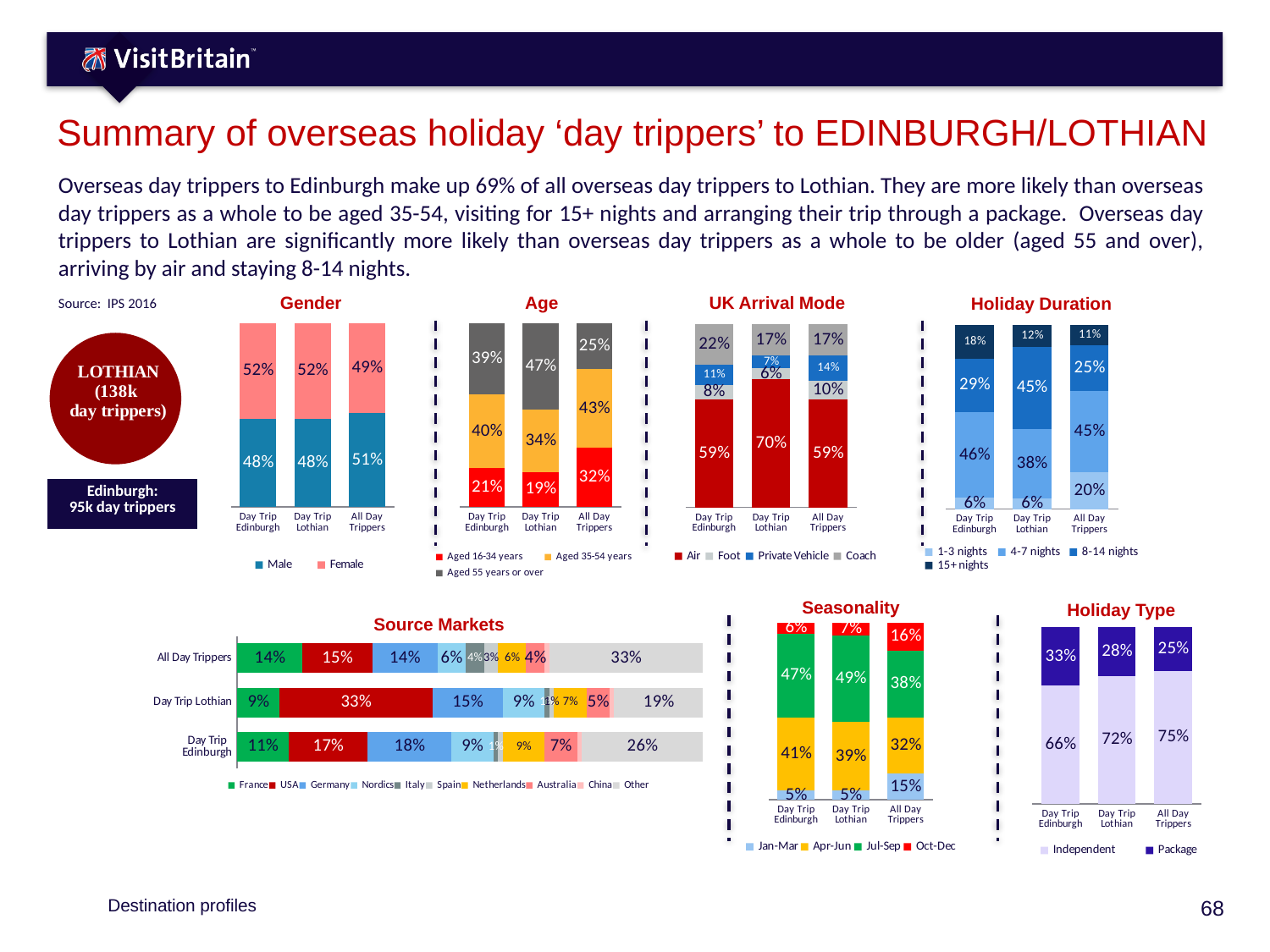
In the Seasonality chart, what percentage of Day Trip Lothian visitors come in Jul-Sep? 49% In the UK Arrival Mode chart, what is the difference between the Air share for Day Trip Lothian and for Day Trip Edinburgh? 11% In the Age chart, what share of Day Trip Lothian visitors are Aged 55 years or over? 47% In the Source Markets chart, what is the Germany share for Day Trip Edinburgh? 18% How many series does the legend of the UK Arrival Mode chart list? 4 In the Holiday Type chart, what percentage of Day Trip Edinburgh visitors travel on a Package? 33% In the Holiday Duration chart, which group has the lowest share staying 1-3 nights, Day Trip Lothian or All Day Trippers? Day Trip Lothian In the Age chart, which group has the highest share of visitors Aged 16-34 years? All Day Trippers In the Gender chart, what percentage of Day Trip Lothian visitors are Female? 52% In the Source Markets chart, what is the USA share for Day Trip Lothian? 33% In the UK Arrival Mode chart, what percentage of Day Trip Lothian visitors arrive by Air? 70% In the Holiday Duration chart, what percentage of Day Trip Edinburgh visitors stay 4-7 nights? 46%